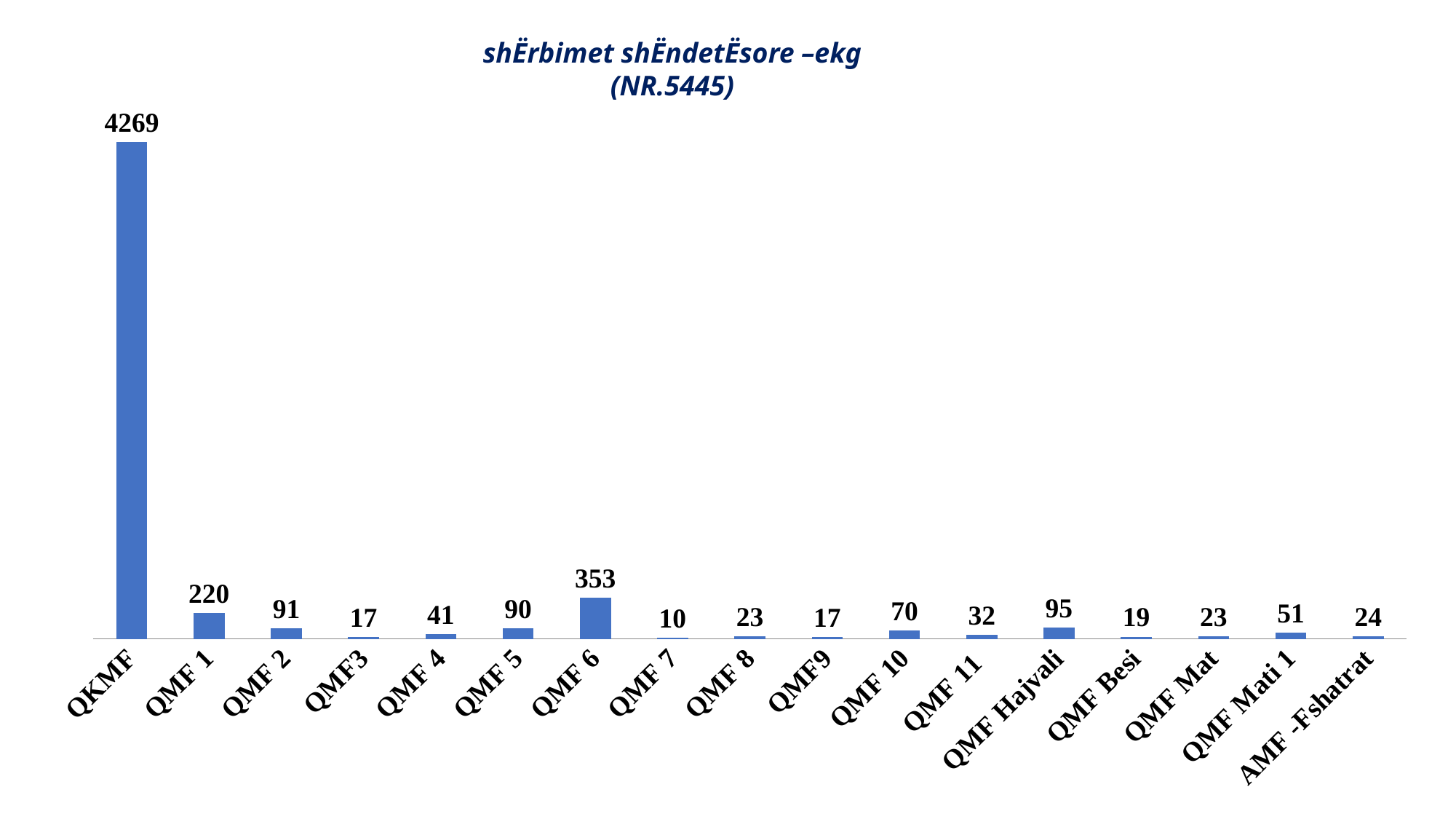
What is the value for QMF 6? 353 Which is larger, the value for QMF 10 or the value for QMF 11? QMF 10 What is the difference between the values for QMF 6 and QMF 1? 133 What is the difference between the values for QMF 2 and QMF 5? 1 What is the value for QKMF? 4269 What is the value for QMF Hajvali? 95 How many categories are shown on the x axis? 17 What is the value for QMF Mati 1? 51 Which category has the lowest value? QMF 7 What kind of chart is shown on the slide? Bar chart What is the title of the chart? shËrbimet shËndetËsore –ekg (NR.5445) Which category has the highest value? QKMF